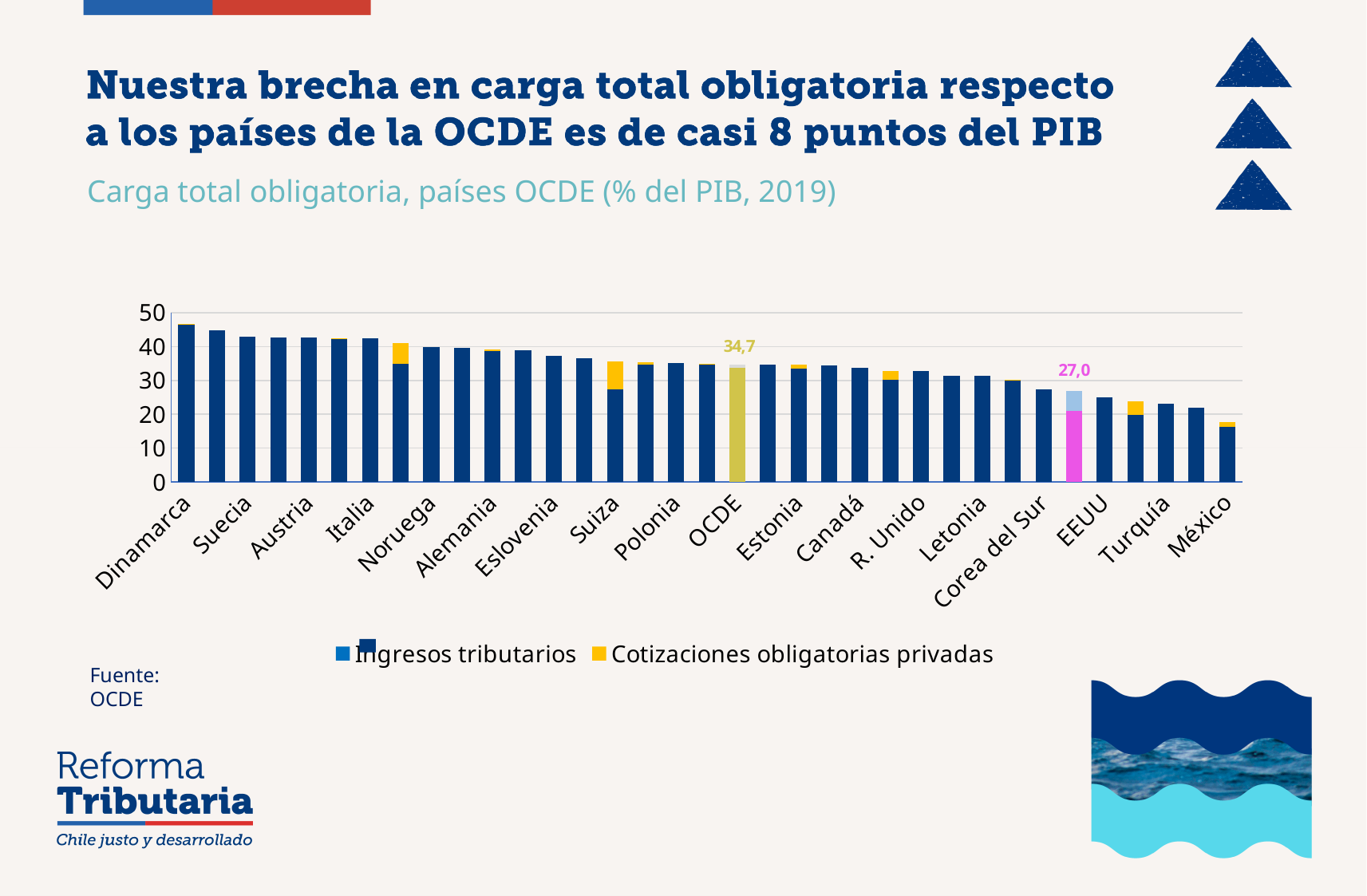
How many series does the legend list? 2 Is the total value for Dinamarca greater or less than 40? greater Which labelled country has the highest total bar? Dinamarca What kind of chart is shown on the slide? Bar chart What value is labelled on the OCDE bar? 34,7 Do the total bar values rise or fall from left to right along the x axis? Fall Which labelled country has the lowest total bar? México Which has a higher total bar, Suecia or Polonia? Suecia Is the total value for Turquía greater or less than 30? less Is the total value for México greater or less than 20? less